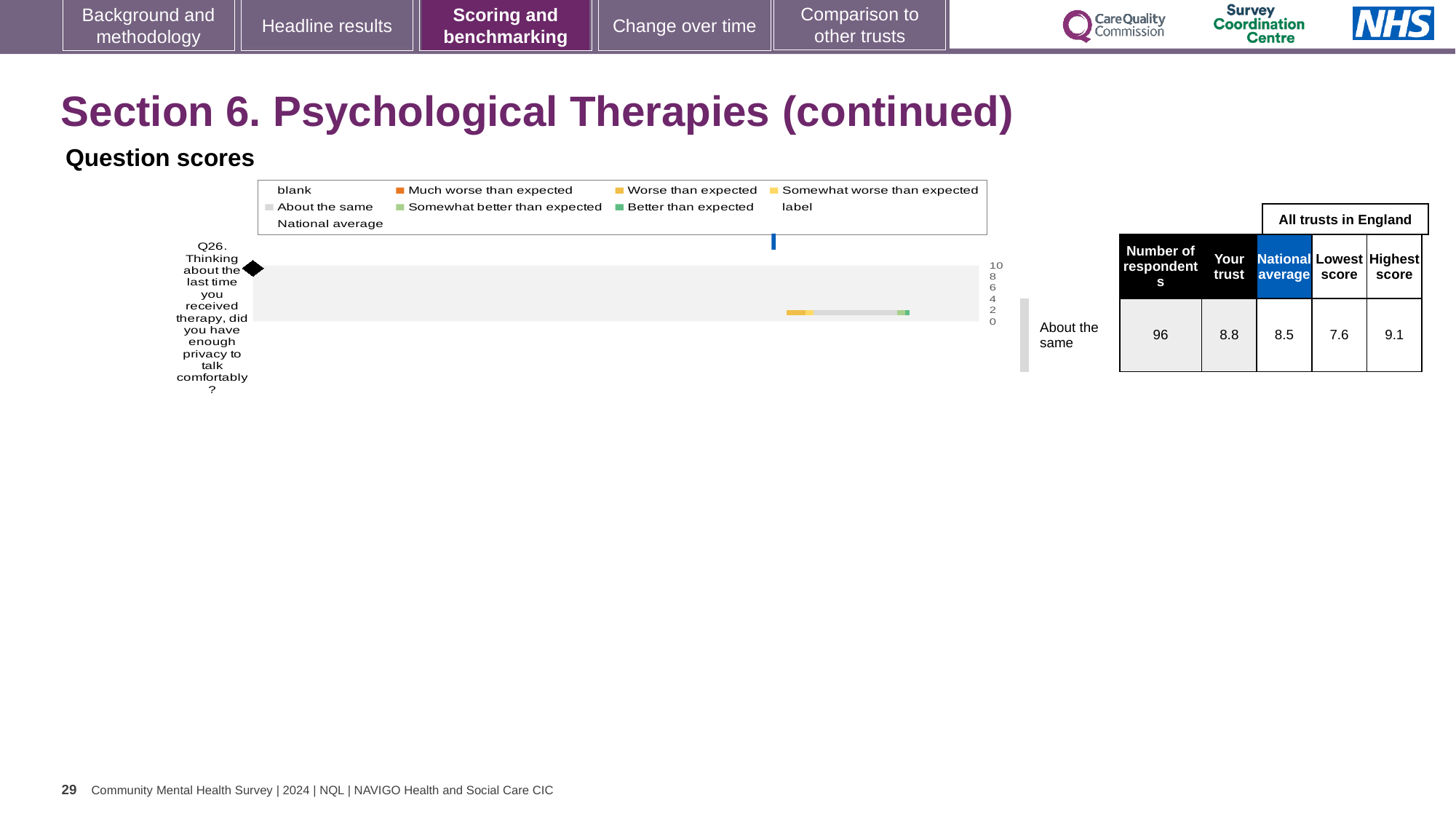
What is the difference between the highest and lowest scores among all trusts in England for Q26? 1.5 What is the score for 'Your trust' on Q26 about having enough privacy to talk comfortably during therapy? 8.8 How many survey questions are plotted on the chart? 1 What benchmarking category is the trust's Q26 score placed in? About the same What is the national average score for Q26? 8.5 How many respondents answered Q26? 96 What kind of chart is shown on the slide? bar chart What is the difference between the 'Your trust' score and the national average for Q26? 0.3 Which is larger for Q26: the 'Your trust' score or the national average? Your trust Is the 'Your trust' score for Q26 greater or less than 8? greater What is the lowest score among all trusts in England for Q26? 7.6 What is the highest score among all trusts in England for Q26? 9.1